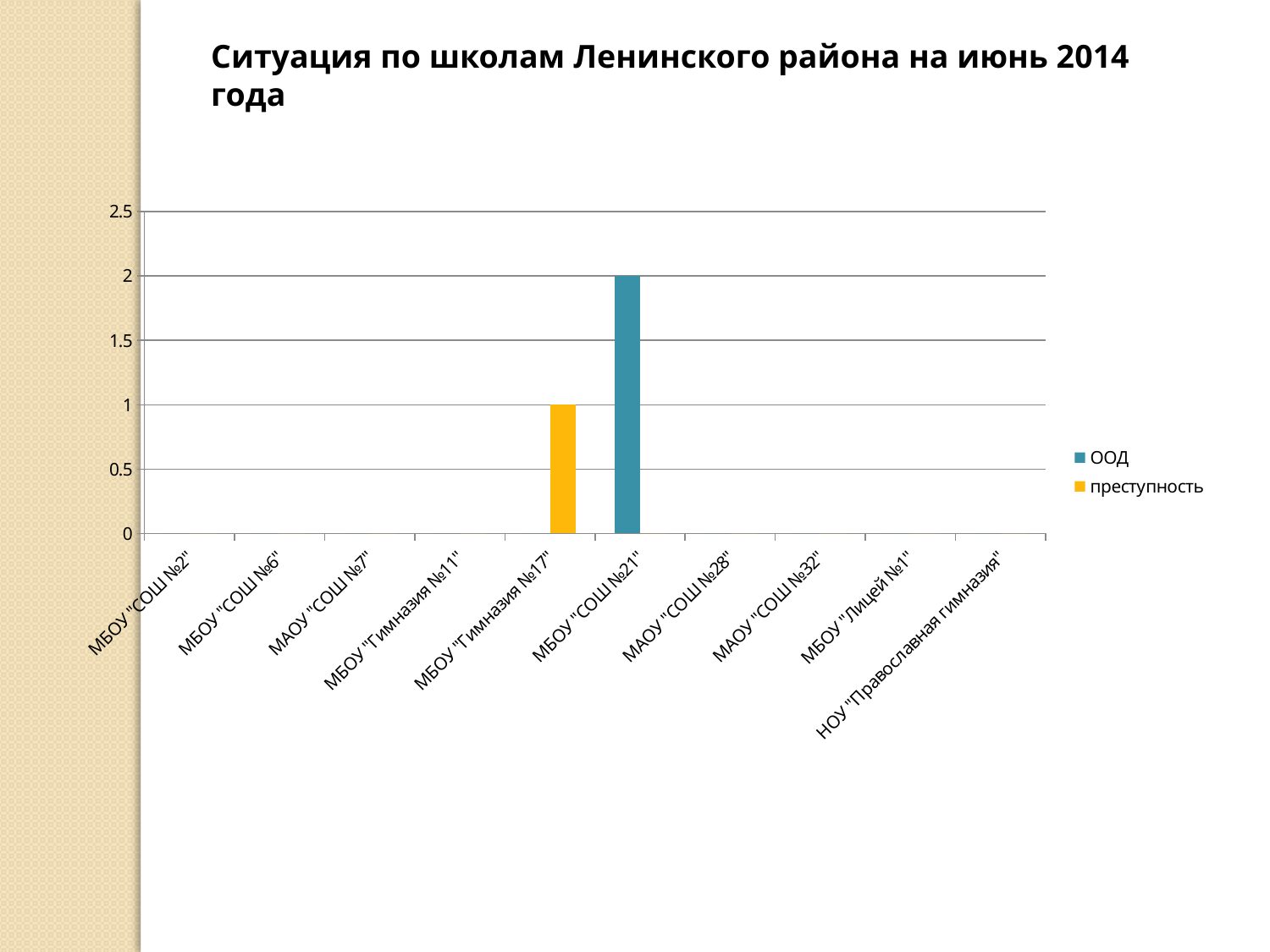
What is the title of the chart? Ситуация по школам Ленинского района на июнь 2014 года Which legend entry is shown in yellow? преступность Which is larger: the ООД value for МБОУ "СОШ №21" or the преступность value for МБОУ "Гимназия №17"? ООД value for МБОУ "СОШ №21" What kind of chart is shown on the slide? bar chart What is the преступность value for МБОУ "Гимназия №17"? 1 Is the ООД value for МБОУ "СОШ №21" greater or less than 1.5? greater How many schools (categories) are shown on the x axis? 10 How many series does the legend list? 2 Which school has the highest ООД value? МБОУ "СОШ №21" Which school has the highest преступность value? МБОУ "Гимназия №17" What is the ООД value for МБОУ "СОШ №21"? 2 What is the difference between the ООД value for МБОУ "СОШ №21" and the преступность value for МБОУ "Гимназия №17"? 1